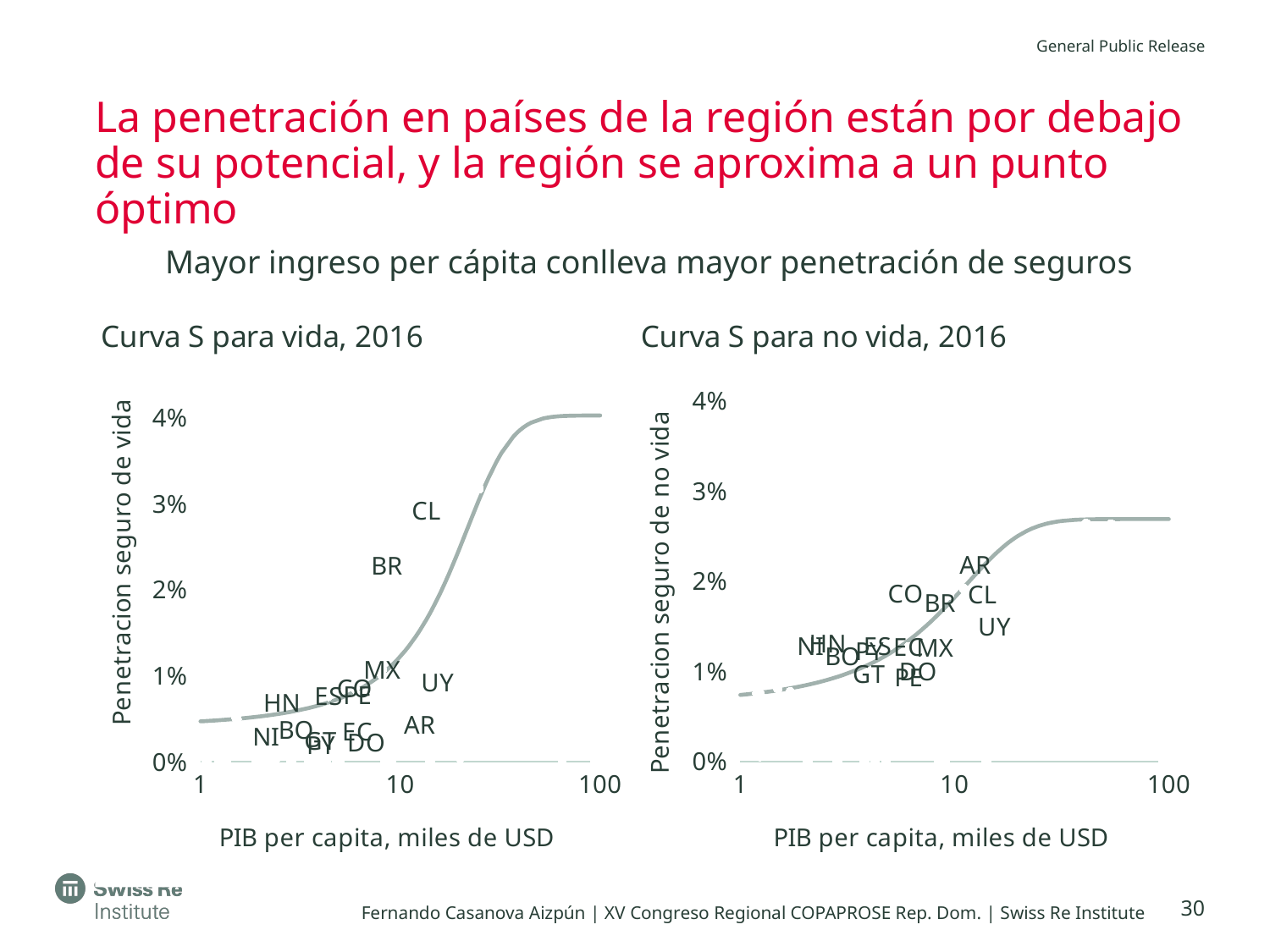
In the 'Curva S para no vida, 2016' chart, is the penetration value for UY greater or less than 2%? less What is the x-axis label of the 'Curva S para vida, 2016' chart? PIB per capita, miles de USD In the 'Curva S para vida, 2016' chart, which has the higher penetration, UY or AR? UY In the 'Curva S para vida, 2016' chart, is the penetration value for HN greater or less than 1%? less What kind of chart is the 'Curva S para vida, 2016' chart? scatter chart In the 'Curva S para no vida, 2016' chart, is the penetration value for CO greater or less than 1%? greater In the 'Curva S para no vida, 2016' chart, which has the higher penetration, AR or UY? AR In the 'Curva S para vida, 2016' chart, which has the higher penetration, CL or BR? CL What is the title of the chart on the right side of the slide? Curva S para no vida, 2016 In the 'Curva S para vida, 2016' chart, which country has the highest life insurance penetration? CL